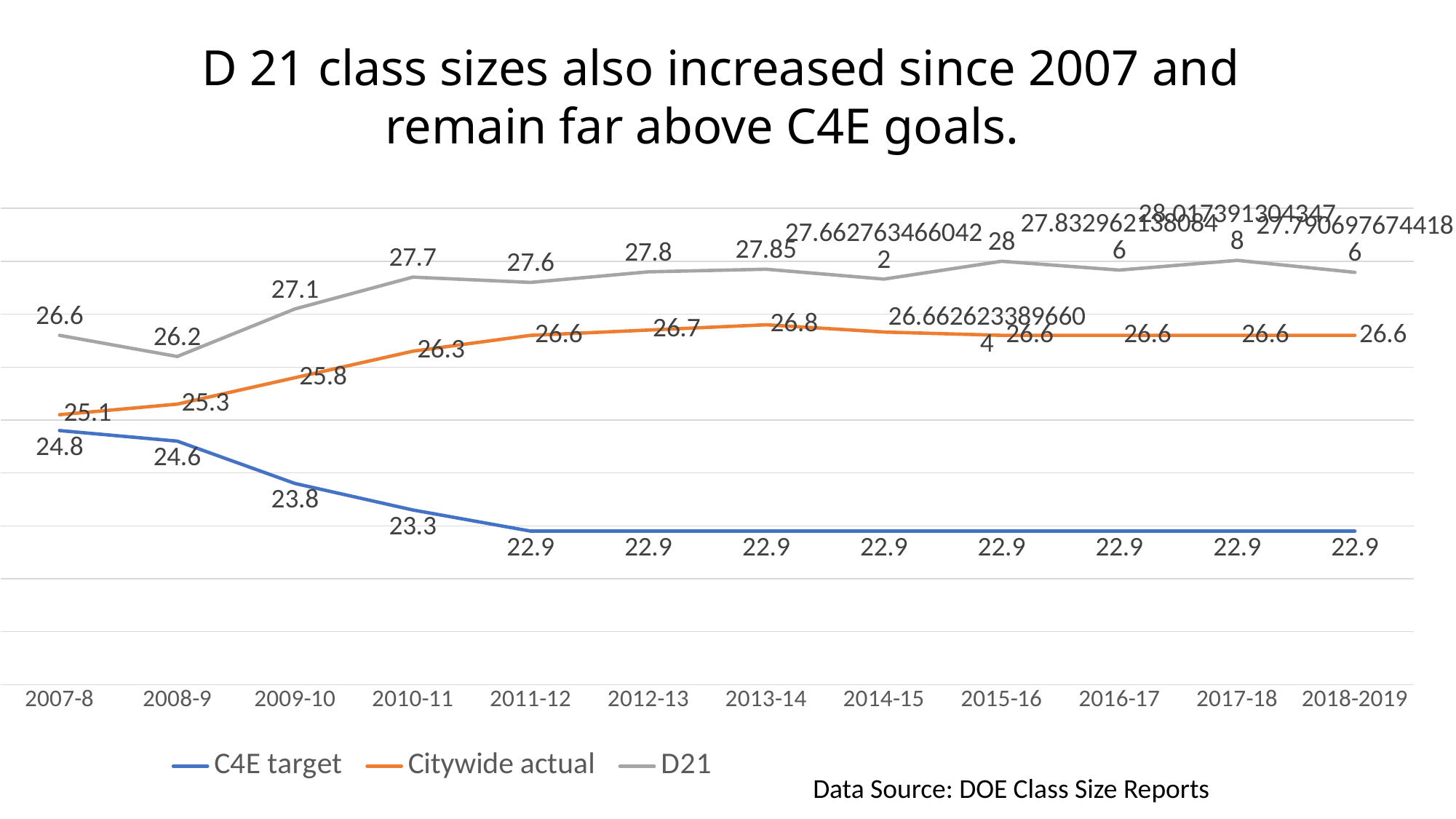
What is the D21 value for 2010-11? 27.7 By how much did the C4E target fall from 2007-8 to 2018-2019? 1.9 How many school years are shown on the x axis? 12 In 2007-8, which is larger: the D21 value or the Citywide actual value? D21 How many series does the legend list? 3 Does the C4E target rise or fall from 2007-8 to 2011-12? fall In 2012-13, how much higher is the D21 value than the Citywide actual value? 1.1 What kind of chart is shown on the slide? line chart What is the C4E target value for 2007-8? 24.8 What is the D21 value for 2015-16? 28 In which school year is the D21 value lowest? 2008-9 What is the Citywide actual value for 2013-14? 26.8